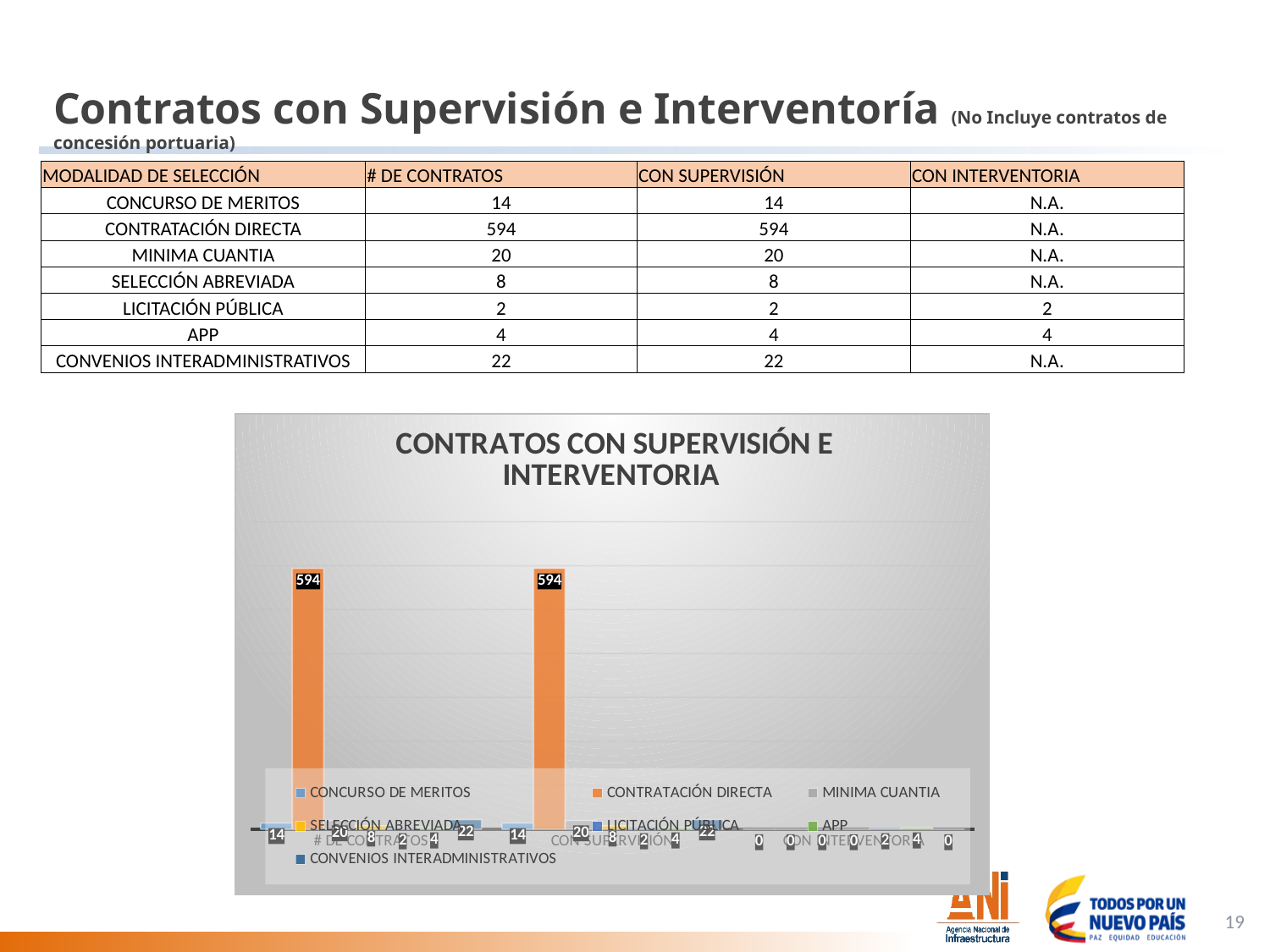
In the chart, which is larger in the CON INTERVENTORIA group: APP or LICITACIÓN PÚBLICA? APP In the chart, what is the value for APP in the CON INTERVENTORIA group? 4 In the chart, what is the value for CONTRATACIÓN DIRECTA in the CON SUPERVISIÓN group? 594 In the chart, what is the difference between the CONTRATACIÓN DIRECTA value and the CONVENIOS INTERADMINISTRATIVOS value in the # DE CONTRATOS group? 572 What is the title of the chart? CONTRATOS CON SUPERVISIÓN E INTERVENTORIA In the chart, which series has the highest value in the # DE CONTRATOS group? CONTRATACIÓN DIRECTA In the chart, what is the value for CONVENIOS INTERADMINISTRATIVOS in the # DE CONTRATOS group? 22 What type of chart is shown on the slide? bar chart How many series does the chart legend list? 7 In the chart, what is the value for CONTRATACIÓN DIRECTA in the # DE CONTRATOS group? 594 In the chart, what is the value for LICITACIÓN PÚBLICA in the CON INTERVENTORIA group? 2 How many category groups are shown along the x axis of the chart? 3